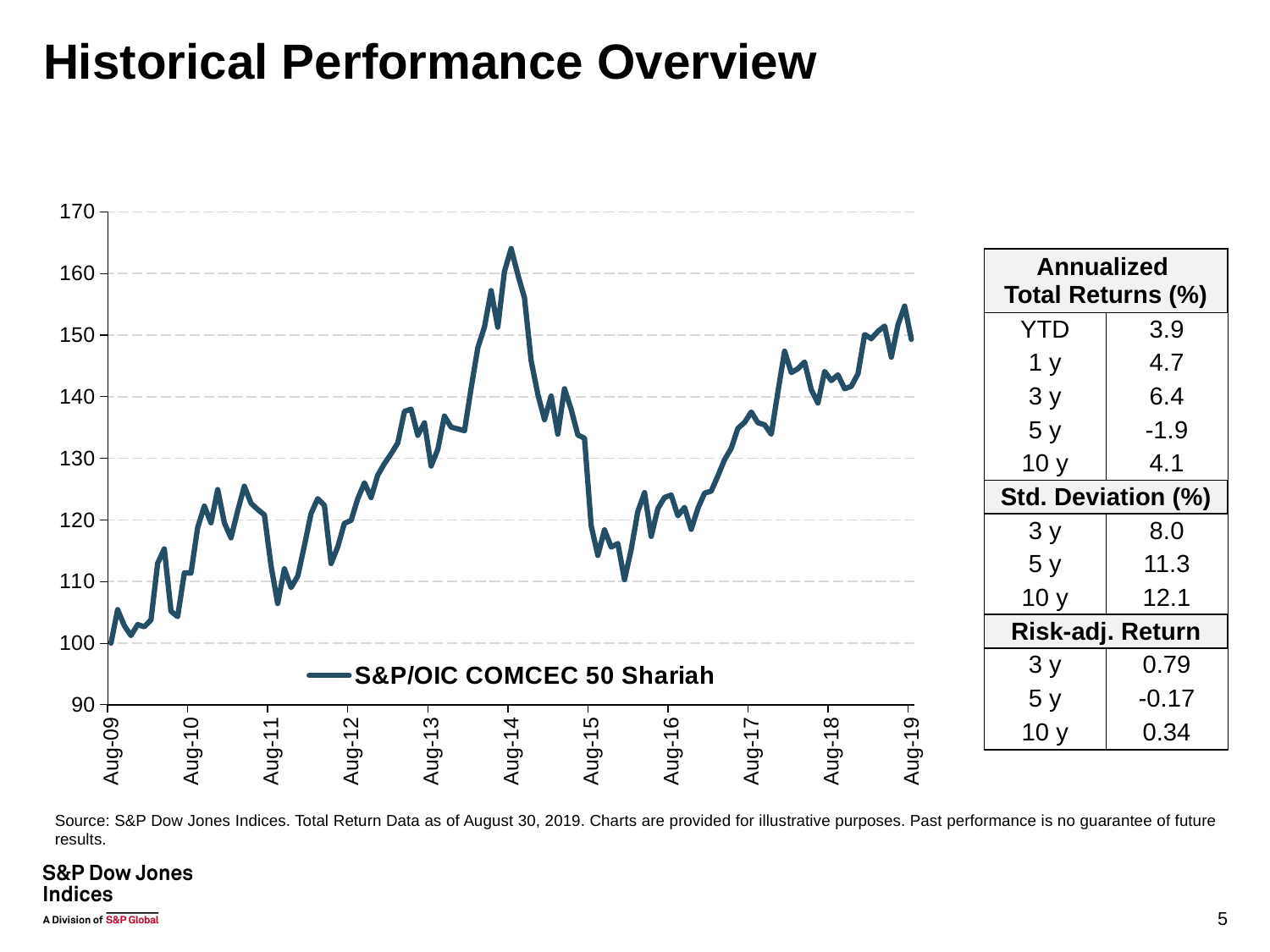
Is the value of the S&P/OIC COMCEC 50 Shariah line at Aug-14 greater or less than 160? greater Is the value of the S&P/OIC COMCEC 50 Shariah line at Aug-16 greater or less than 130? less How many date labels are shown along the x axis of the chart? 11 Overall, does the S&P/OIC COMCEC 50 Shariah line rise or fall from Aug-09 to Aug-19? rise Is the value of the S&P/OIC COMCEC 50 Shariah line at Aug-10 greater or less than 100? greater What is the name of the series shown in the chart legend? S&P/OIC COMCEC 50 Shariah How many series does the chart legend list? 1 What kind of chart is shown on the slide? line chart Near which x-axis label does the S&P/OIC COMCEC 50 Shariah line reach its highest point? Aug-14 Is the S&P/OIC COMCEC 50 Shariah line higher at Aug-14 or at Aug-16? Aug-14